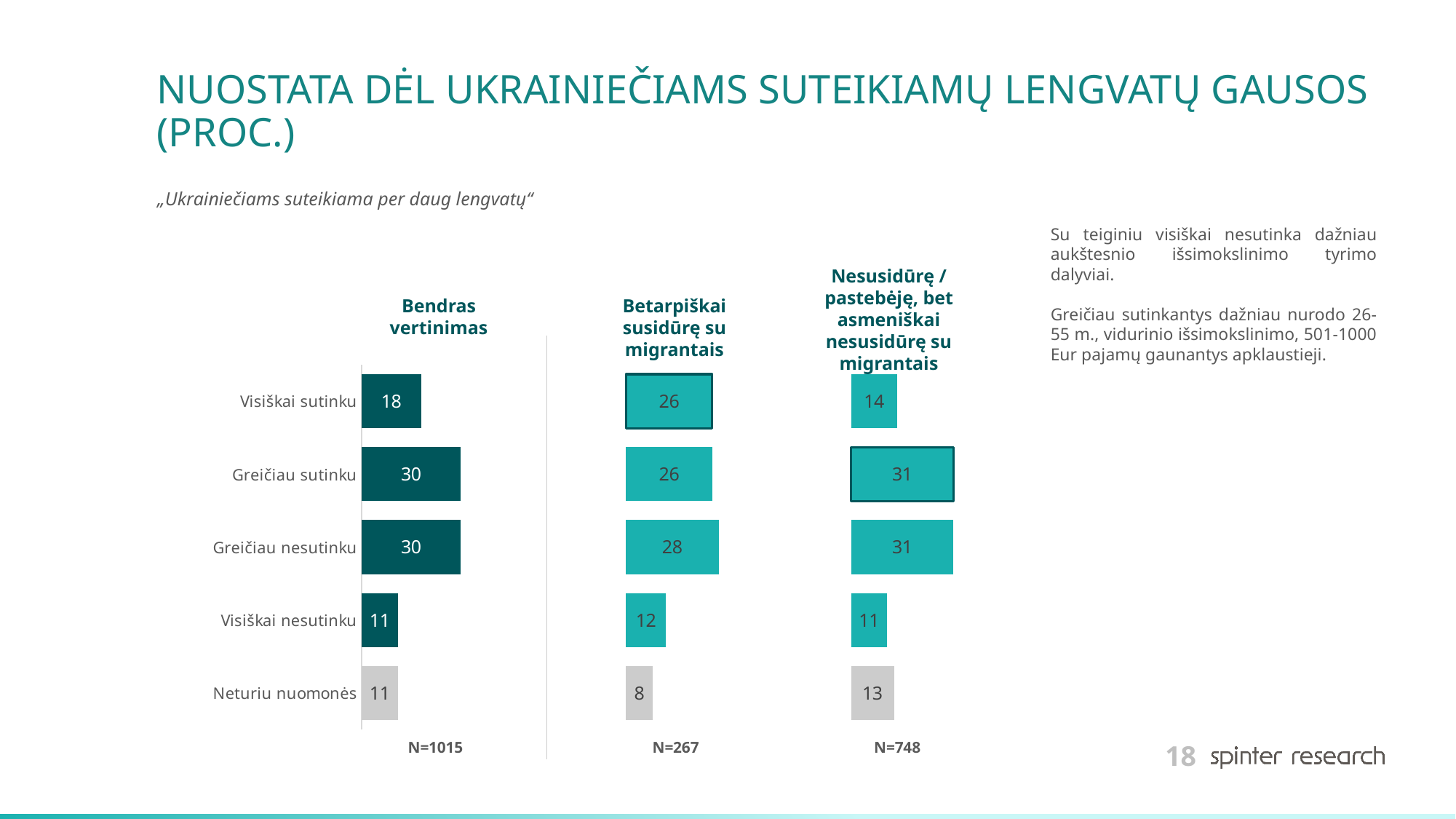
Which is larger: "Visiškai sutinku" in the "Betarpiškai susidūrę su migrantais" chart or "Visiškai sutinku" in the "Nesusidūrę / pastebėję, bet asmeniškai nesusidūrę su migrantais" chart? Betarpiškai susidūrę su migrantais In the "Betarpiškai susidūrę su migrantais" chart, which category has the lowest value? Neturiu nuomonės In the "Bendras vertinimas" chart, what is the difference between "Greičiau sutinku" and "Visiškai sutinku"? 12 In the "Nesusidūrę / pastebėję, bet asmeniškai nesusidūrę su migrantais" chart, what is the value for "Neturiu nuomonės"? 13 In the "Bendras vertinimas" chart, what is the value for "Visiškai sutinku"? 18 How many categories does the "Bendras vertinimas" chart show? 5 In the "Betarpiškai susidūrę su migrantais" chart, what is the value for "Greičiau nesutinku"? 28 What kind of chart is the "Bendras vertinimas" chart? Bar chart What is the sample size (N) shown under the "Betarpiškai susidūrę su migrantais" chart? N=267 In the "Nesusidūrę / pastebėję, bet asmeniškai nesusidūrę su migrantais" chart, what is the difference between "Greičiau sutinku" and "Visiškai sutinku"? 17 In the "Nesusidūrę / pastebėję, bet asmeniškai nesusidūrę su migrantais" chart, which category has the lowest value? Visiškai nesutinku In the "Betarpiškai susidūrę su migrantais" chart, which category has the highest value? Greičiau nesutinku